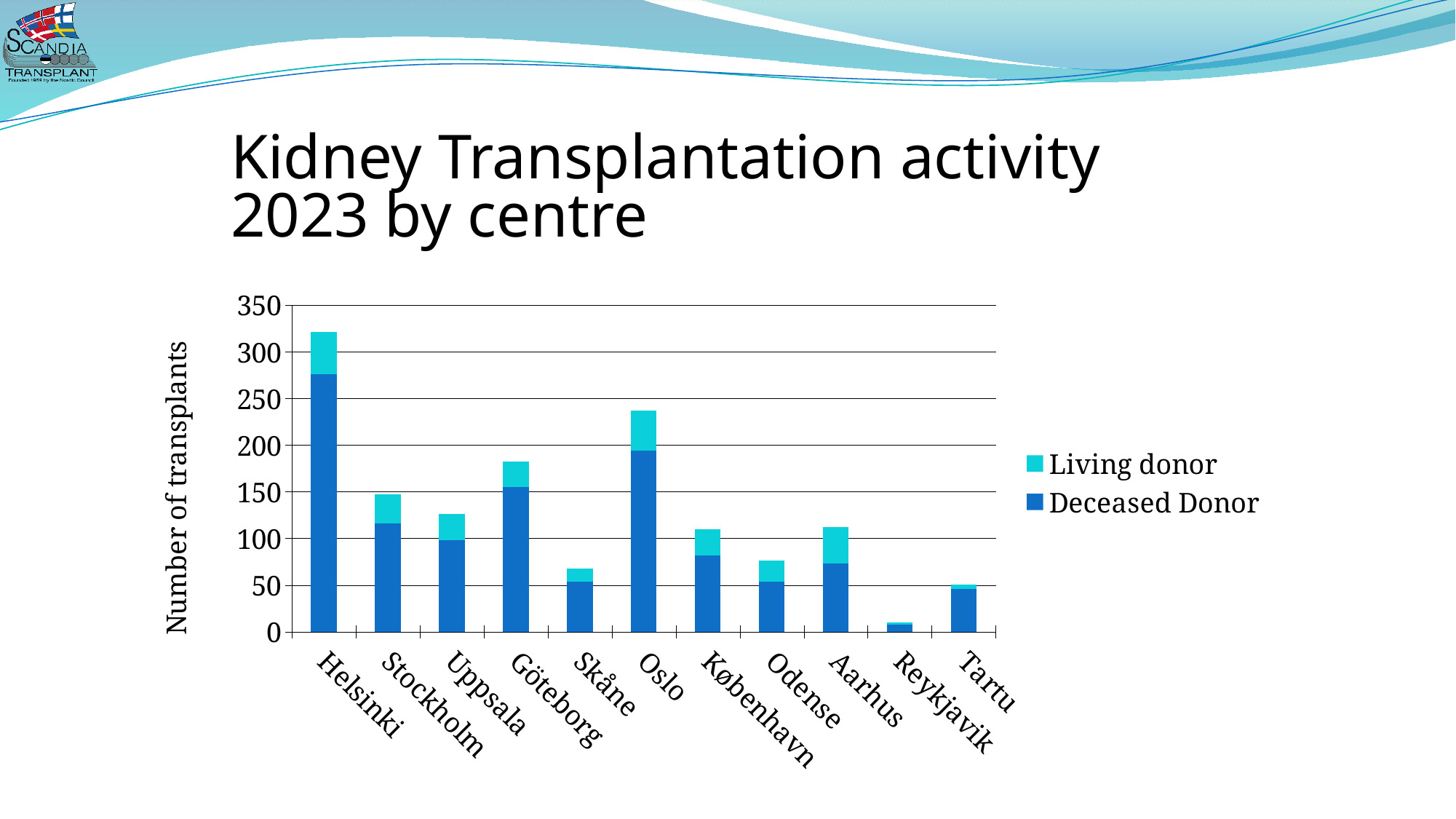
Is the total number of transplants for Reykjavik greater or less than 50? less Which centre has a higher total number of transplants, Aarhus or Odense? Aarhus Which centre has a higher total number of transplants, Oslo or Göteborg? Oslo How many series does the legend list? 2 How many centres are shown on the x axis of the chart? 11 Is the total number of transplants for Helsinki greater or less than 300? greater Is the total number of transplants for Oslo greater or less than 200? greater Which centre has the lowest total number of transplants? Reykjavik What kind of chart is shown on the slide? Stacked bar chart What is the label of the y axis? Number of transplants Which centre has the highest total number of transplants? Helsinki